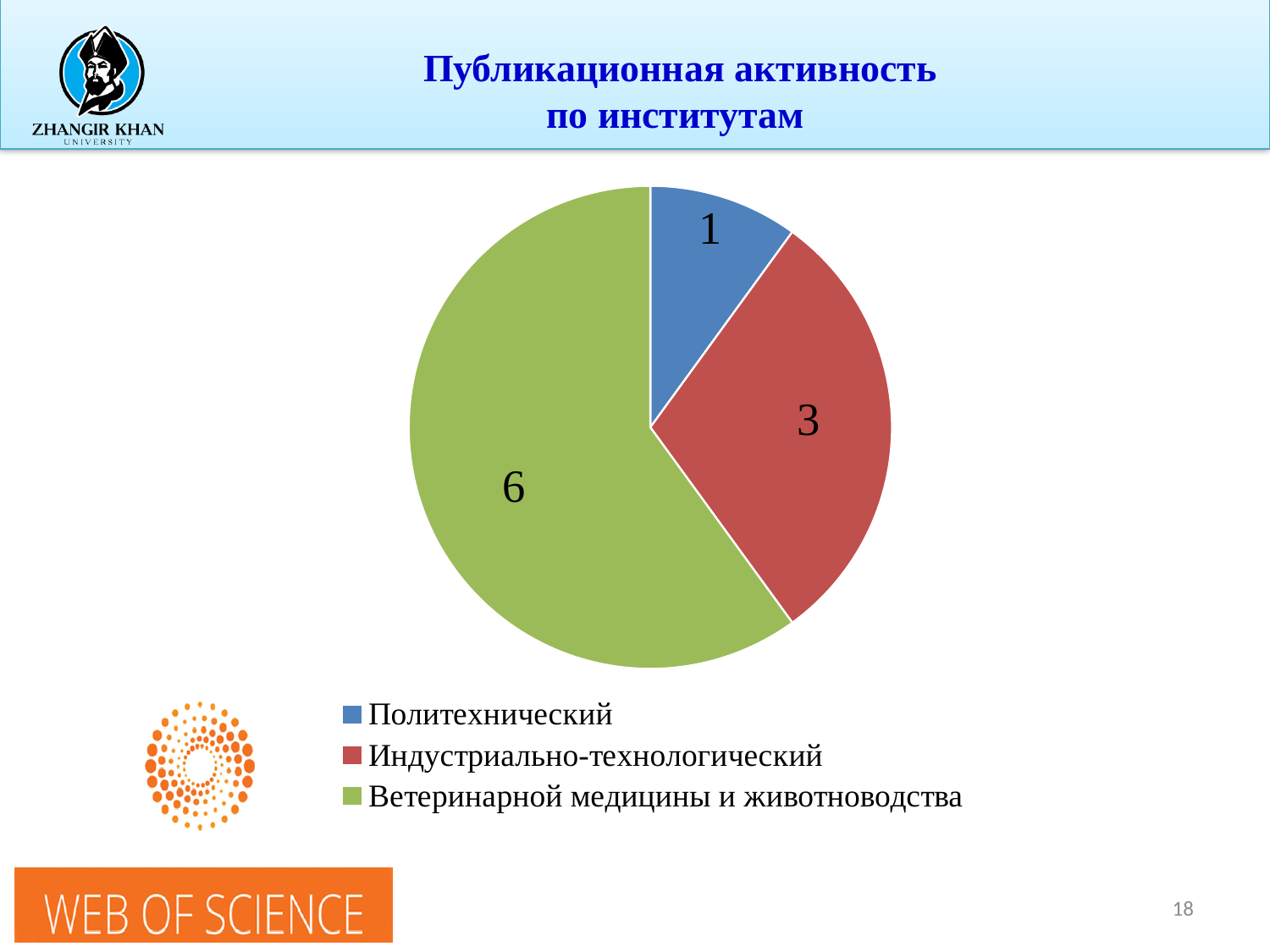
What is the difference between the values for Ветеринарной медицины и животноводства and Индустриально-технологический? 3 What is the total of all slices in the pie chart? 10 What colour is the slice for Индустриально-технологический? red What is the value for Ветеринарной медицины и животноводства? 6 Which institute has the smallest slice of the pie? Политехнический How many slices does the pie chart have? 3 What kind of chart is shown on the slide? pie chart What share of the pie does Ветеринарной медицины и животноводства represent? 60% What is the value for Политехнический? 1 Which is larger, the value for Индустриально-технологический or the value for Политехнический? Индустриально-технологический Which institute has the largest slice of the pie? Ветеринарной медицины и животноводства What is the value for Индустриально-технологический? 3